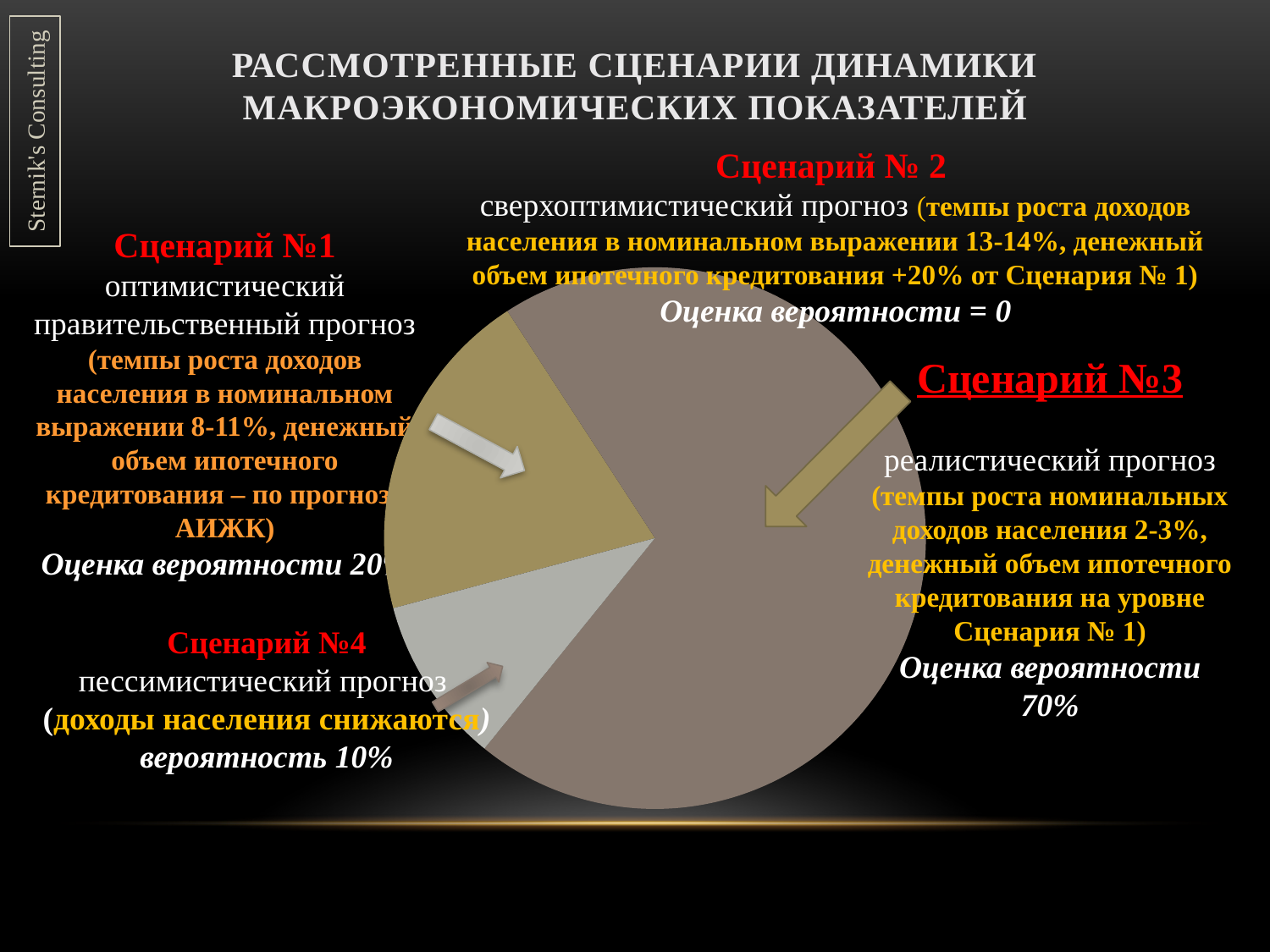
Which scenario has the largest slice of the pie chart? Сценарий №3 What kind of chart is shown on the slide? Pie chart What is the probability estimate (оценка вероятности) for Сценарий №3? 70% What is the probability estimate (оценка вероятности) for Сценарий № 2? 0 What is the probability (вероятность) for Сценарий №4? 10% Which scenario has the smallest slice of the pie chart? Сценарий №4 How many slices does the pie chart have? 3 What share of the pie does Сценарий №3 (реалистический прогноз) take? 70% What is the difference between the probability of Сценарий №3 and the probability of Сценарий №4? 60% Which slice is larger in the pie chart: Сценарий №3 or Сценарий №1? Сценарий №3 What is the title of the slide containing the pie chart? Рассмотренные сценарии динамики макроэкономических показателей Which slice is larger in the pie chart: Сценарий №1 or Сценарий №4? Сценарий №1